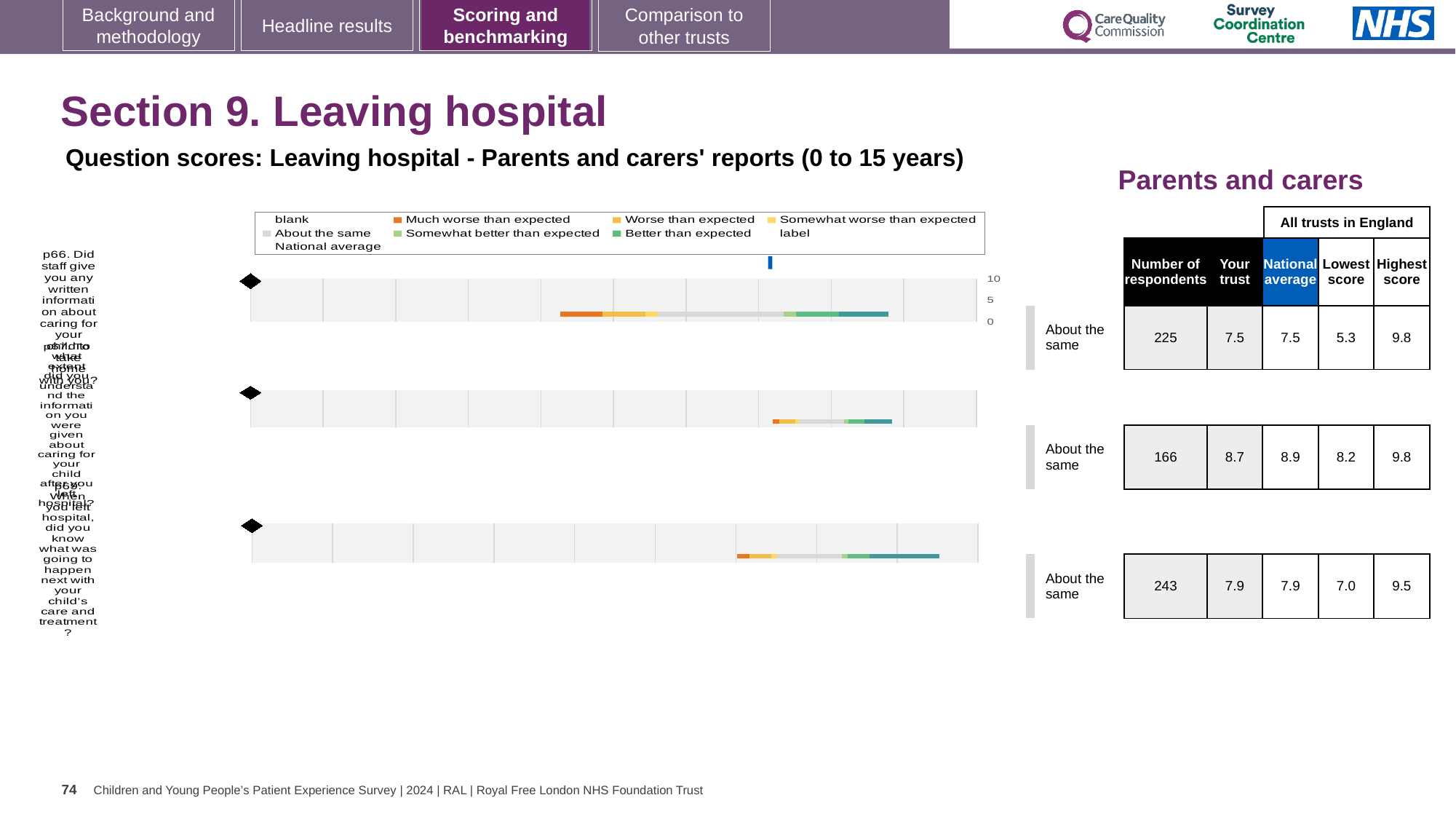
In the table beside the charts, what is the national average for the second question? 8.9 What is the highest value shown on the score axis of the bar charts? 10 In the table beside the charts, what is the number of respondents for the first question (p66)? 225 In the table beside the charts, what is the highest score for the third question? 9.5 In the table beside the charts, what is the lowest score for the second question? 8.2 What kind of chart is used to show the question scores on this slide? bar chart In the table beside the charts, what is the 'Your trust' score for the first question (p66)? 7.5 For the second question, which is larger: the 'Your trust' score or the national average? National average In the chart legend, which colour represents 'Much worse than expected'? orange How many question-score bar charts are shown on the slide? 3 Which of the three questions has the highest number of respondents? The third question (243) For the second question, what is the difference between the national average (8.9) and the 'Your trust' score (8.7)? 0.2